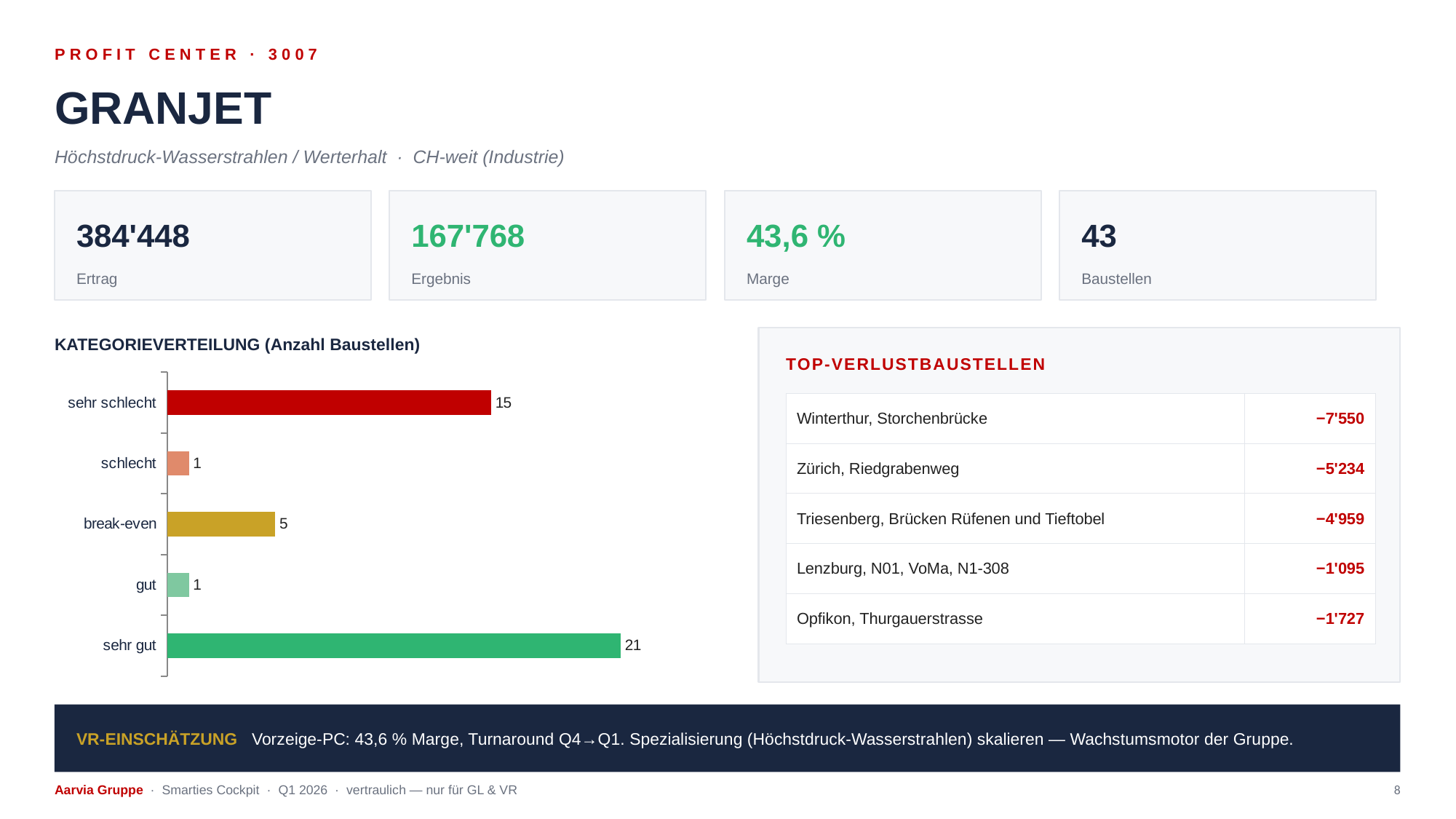
What colour is the 'sehr schlecht' bar in the Kategorieverteilung chart? red Which is larger in the Kategorieverteilung chart, 'sehr schlecht' or 'break-even'? sehr schlecht How many categories are shown in the Kategorieverteilung chart? 5 What is the total of all values shown in the Kategorieverteilung chart? 43 What is the value for 'sehr schlecht' in the Kategorieverteilung chart? 15 What kind of chart is the Kategorieverteilung chart? bar chart What is the difference between the 'sehr gut' and 'sehr schlecht' values in the Kategorieverteilung chart? 6 What is the value for 'sehr gut' in the Kategorieverteilung chart? 21 What is the value for 'schlecht' in the Kategorieverteilung chart? 1 Which category has the highest number of Baustellen in the Kategorieverteilung chart? sehr gut What is the difference between the 'break-even' and 'gut' values in the Kategorieverteilung chart? 4 What is the value for 'break-even' in the Kategorieverteilung chart? 5